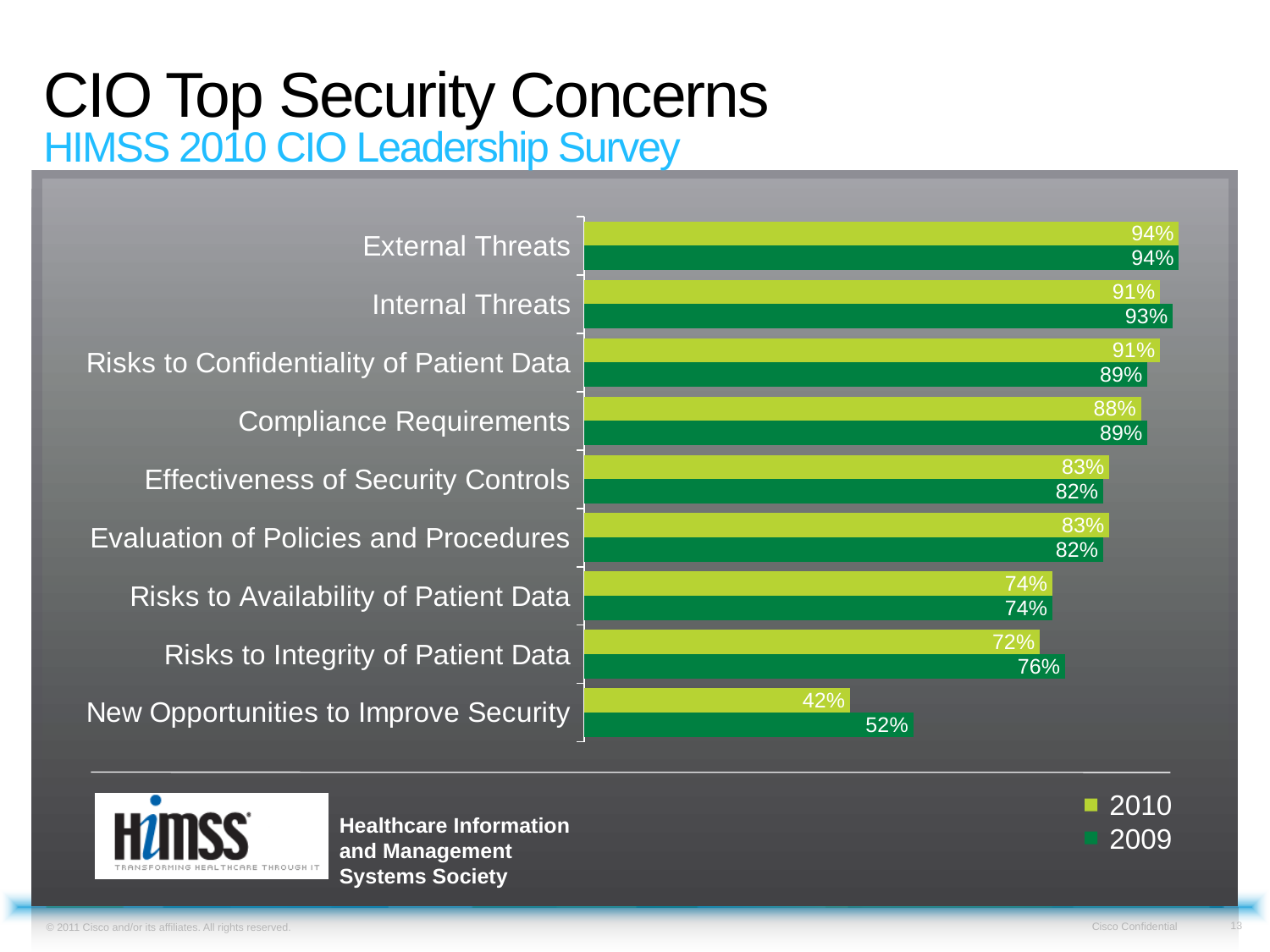
For Risks to Integrity of Patient Data, which year has the larger value, 2010 or 2009? 2009 What is the 2010 value for External Threats? 94% What is the 2010 value for Risks to Integrity of Patient Data? 72% What kind of chart is shown on the slide? Bar chart What is the 2009 value for New Opportunities to Improve Security? 52% What is the 2009 value for Internal Threats? 93% How many series does the legend list? 2 What is the difference between the 2009 and 2010 values for New Opportunities to Improve Security? 10% Which category has the lowest 2009 value? New Opportunities to Improve Security Which series is shown in the lighter green colour? 2010 Which category has the highest 2010 value? External Threats How many categories are shown in the chart? 9